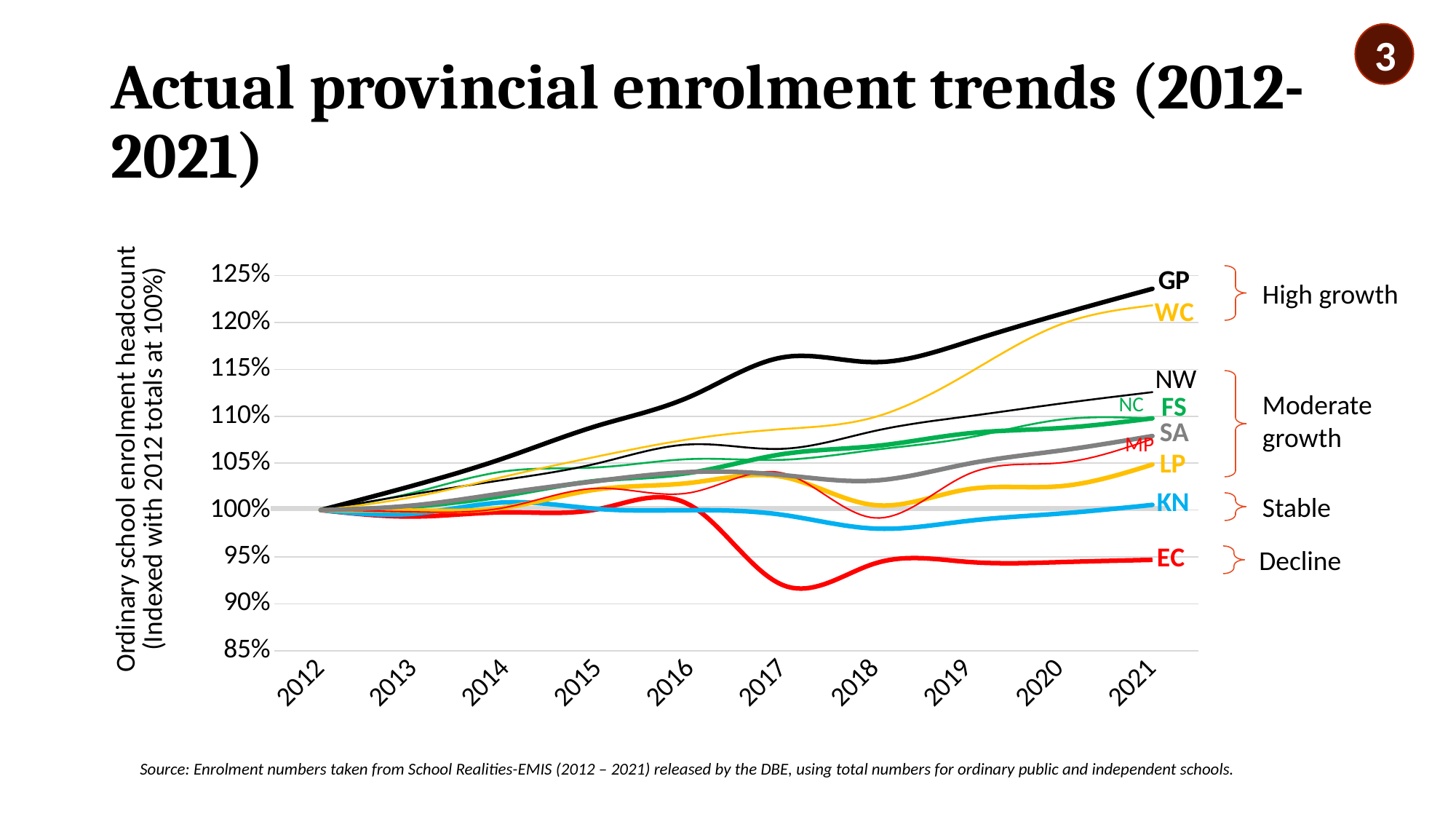
What kind of chart is shown on the slide? line chart Is the value for GP in 2021 greater or less than 120%? greater Which growth category label is the EC line grouped under on the right of the chart? Decline Which province has the lowest indexed enrolment in 2021? EC Which is larger in 2021, the value for WC or the value for LP? WC How many years are shown along the x axis of the chart? 10 Is the value for WC in 2021 greater or less than 115%? greater Is the value for EC in 2017 greater or less than 95%? less What is the indexed enrolment value for every province in 2012? 100% Which province has the highest indexed enrolment in 2021? GP How many provincial series are labelled on the chart? 10 Does the EC line rise or fall overall from 2012 to 2021? fall